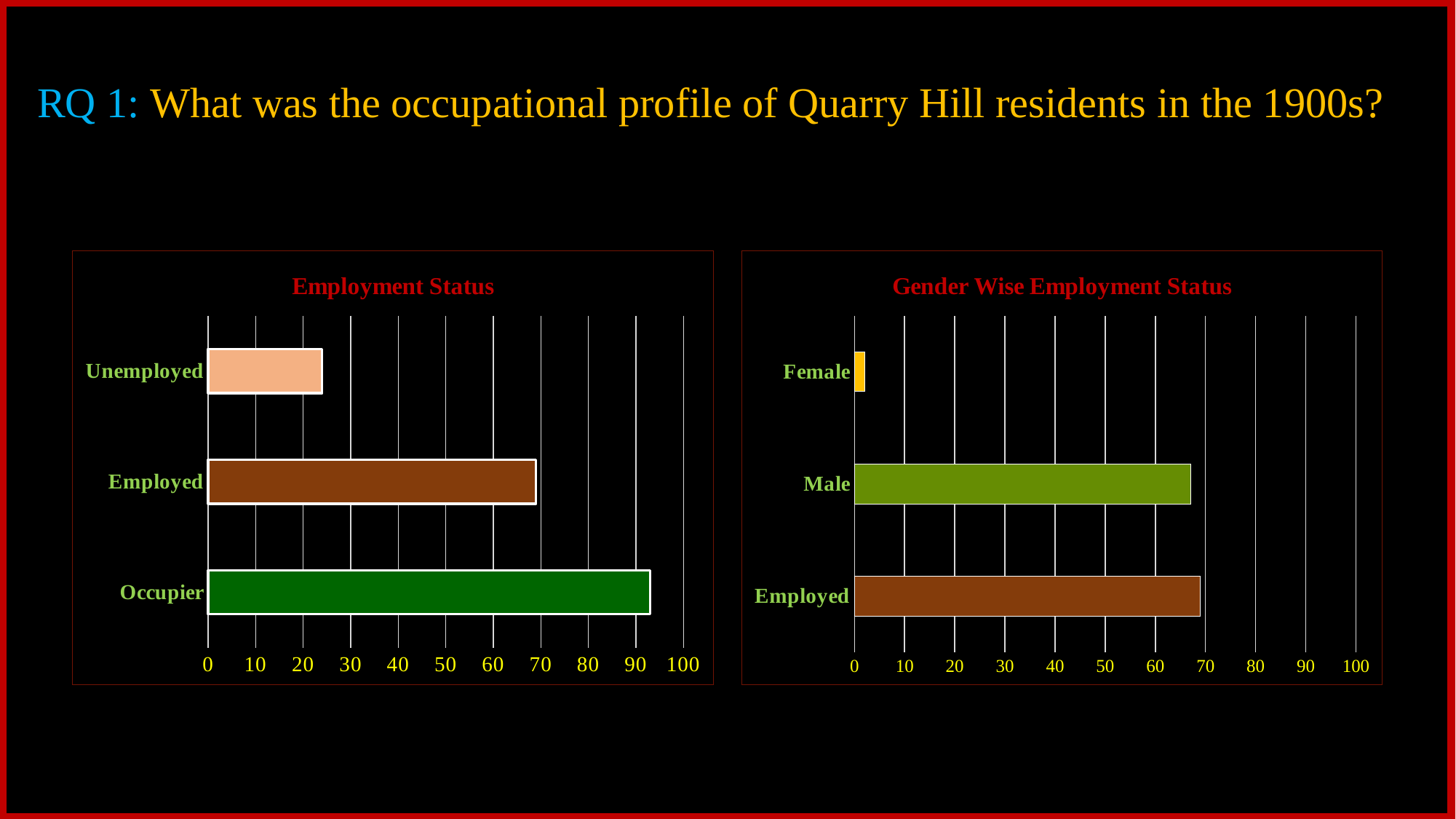
In the Employment Status chart, which category has the lowest value? Unemployed In the Employment Status chart, is the value for Unemployed greater or less than 30? less In the Employment Status chart, is the value for Employed greater or less than 60? greater In the Gender Wise Employment Status chart, which category has the lowest value? Female In the Employment Status chart, which is larger, the value for Employed or the value for Unemployed? Employed What kind of chart is the Gender Wise Employment Status chart? bar chart In the Gender Wise Employment Status chart, is the value for Male greater or less than 60? greater What is the title of the chart on the right side of the slide? Gender Wise Employment Status How many categories are shown in the Employment Status chart? 3 In the Employment Status chart, which category has the highest value? Occupier